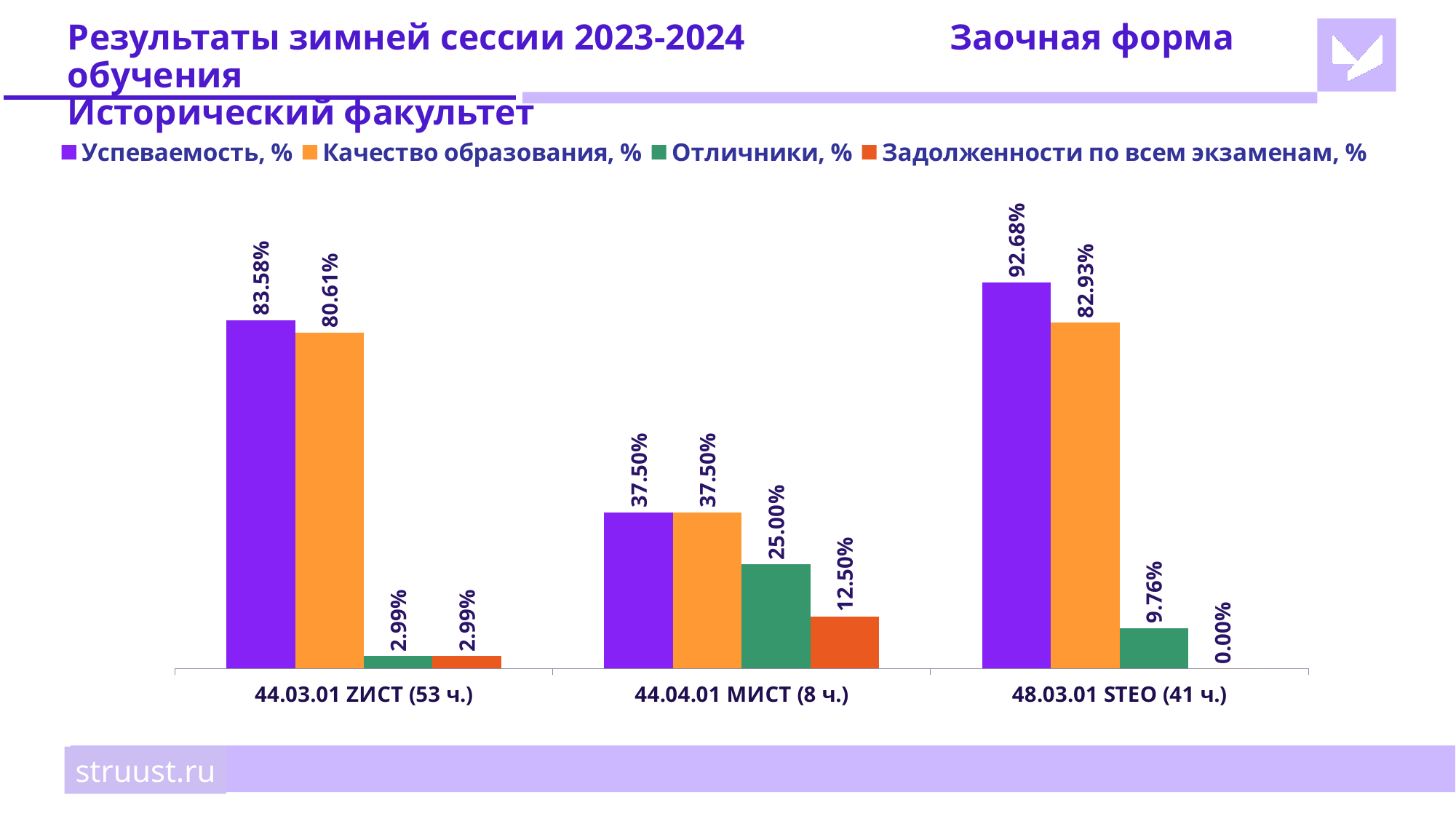
What is the value of Успеваемость, % for 44.03.01 ZИСТ (53 ч.)? 83.58% Which category has the highest value of Успеваемость, %? 48.03.01 STEO (41 ч.) Which category has the lowest value of Качество образования, %? 44.04.01 МИСТ (8 ч.) How many categories are shown on the x axis? 3 Which is larger for 44.03.01 ZИСТ (53 ч.): Успеваемость, % or Качество образования, %? Успеваемость, % What is the difference between Успеваемость, % and Качество образования, % for 48.03.01 STEO (41 ч.)? 9.75% What is the value of Отличники, % for 44.04.01 МИСТ (8 ч.)? 25.00% What is the value of Задолженности по всем экзаменам, % for 48.03.01 STEO (41 ч.)? 0.00% What kind of chart is shown on the slide? Bar chart What is the value of Качество образования, % for 48.03.01 STEO (41 ч.)? 82.93% Which colour represents Отличники, % in the legend? Green How many series does the legend list? 4